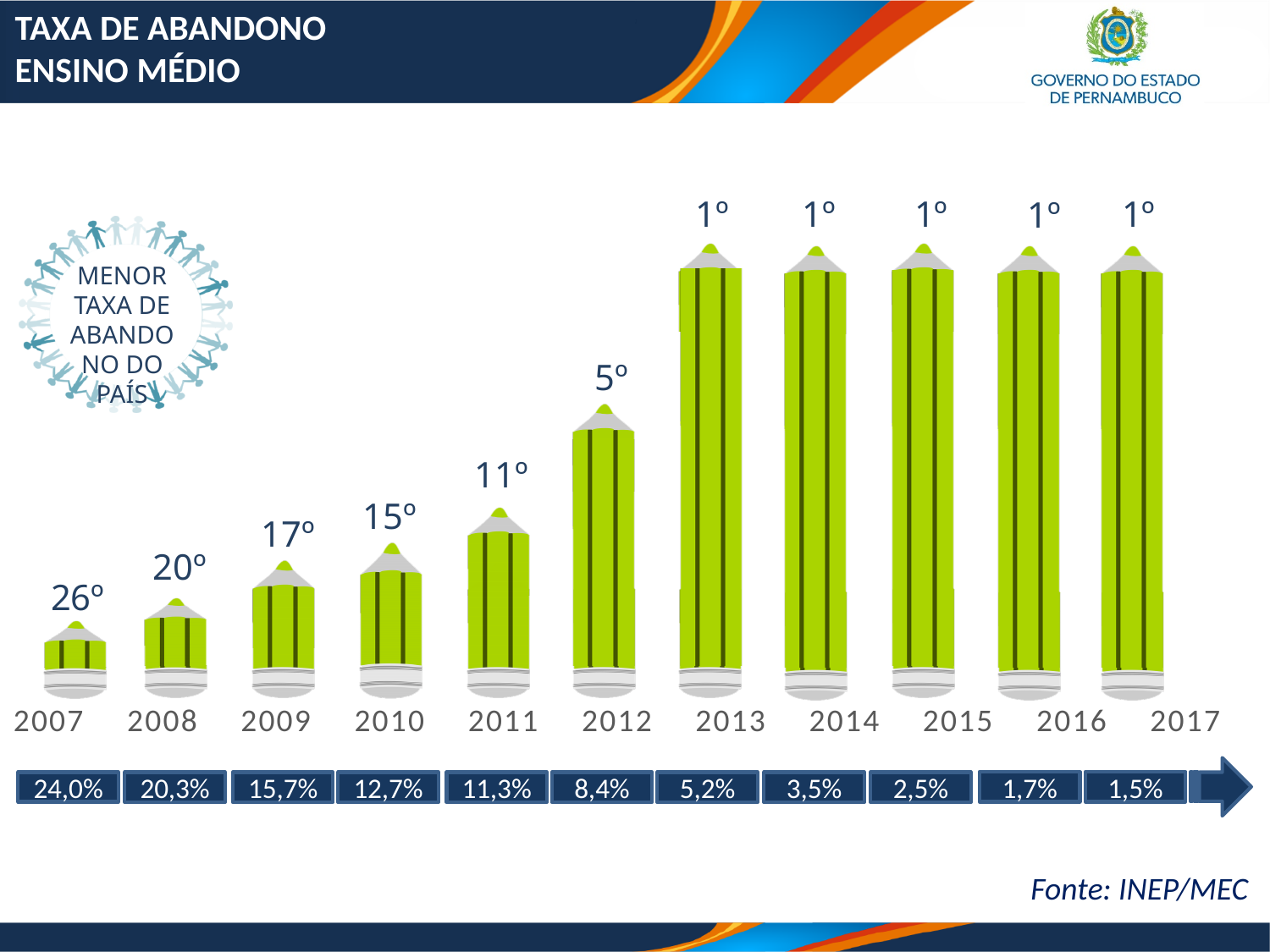
Which year has the highest abandonment rate? 2007 What ranking position is shown for 2007? 26º By how many percentage points did the abandonment rate fall from 2007 to 2017? 22,5 How many years are shown on the chart? 11 In how many years does the chart show a ranking of 1º? 5 What source is cited for the chart data? INEP/MEC What is the abandonment rate (taxa de abandono) shown for 2017? 1,5% Does the abandonment rate rise or fall from 2007 to 2017? fall Which year has a higher abandonment rate, 2010 or 2011? 2010 What ranking position is shown for 2012? 5º Which year has the lowest abandonment rate? 2017 What is the abandonment rate shown for 2013? 5,2%